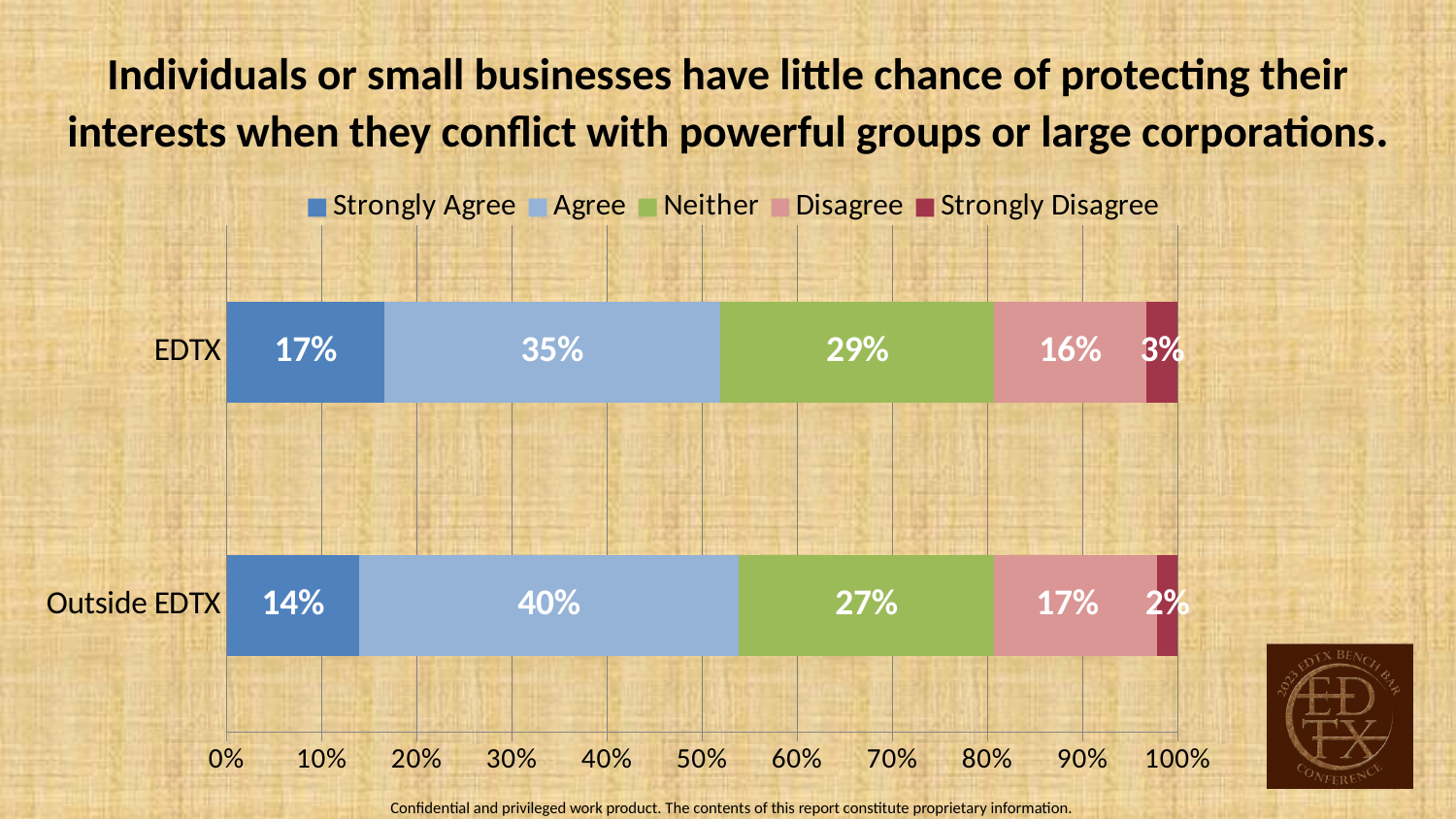
How many groups (bars) are shown on the chart? 2 What percentage of EDTX respondents answered Agree? 35% Which group has a higher Strongly Agree percentage, EDTX or Outside EDTX? EDTX Which response category has the largest share for the EDTX bar? Agree How many series does the legend list? 5 What is the Neither value for Outside EDTX? 27% Which response category has the smallest share for the Outside EDTX bar? Strongly Disagree What is the difference between the Agree values for Outside EDTX and EDTX? 5% What is the Strongly Disagree value for EDTX? 3% What type of chart is shown on the slide? Stacked bar chart What percentage of Outside EDTX respondents answered Strongly Agree? 14% What is the combined percentage of Strongly Agree and Agree for EDTX? 52%